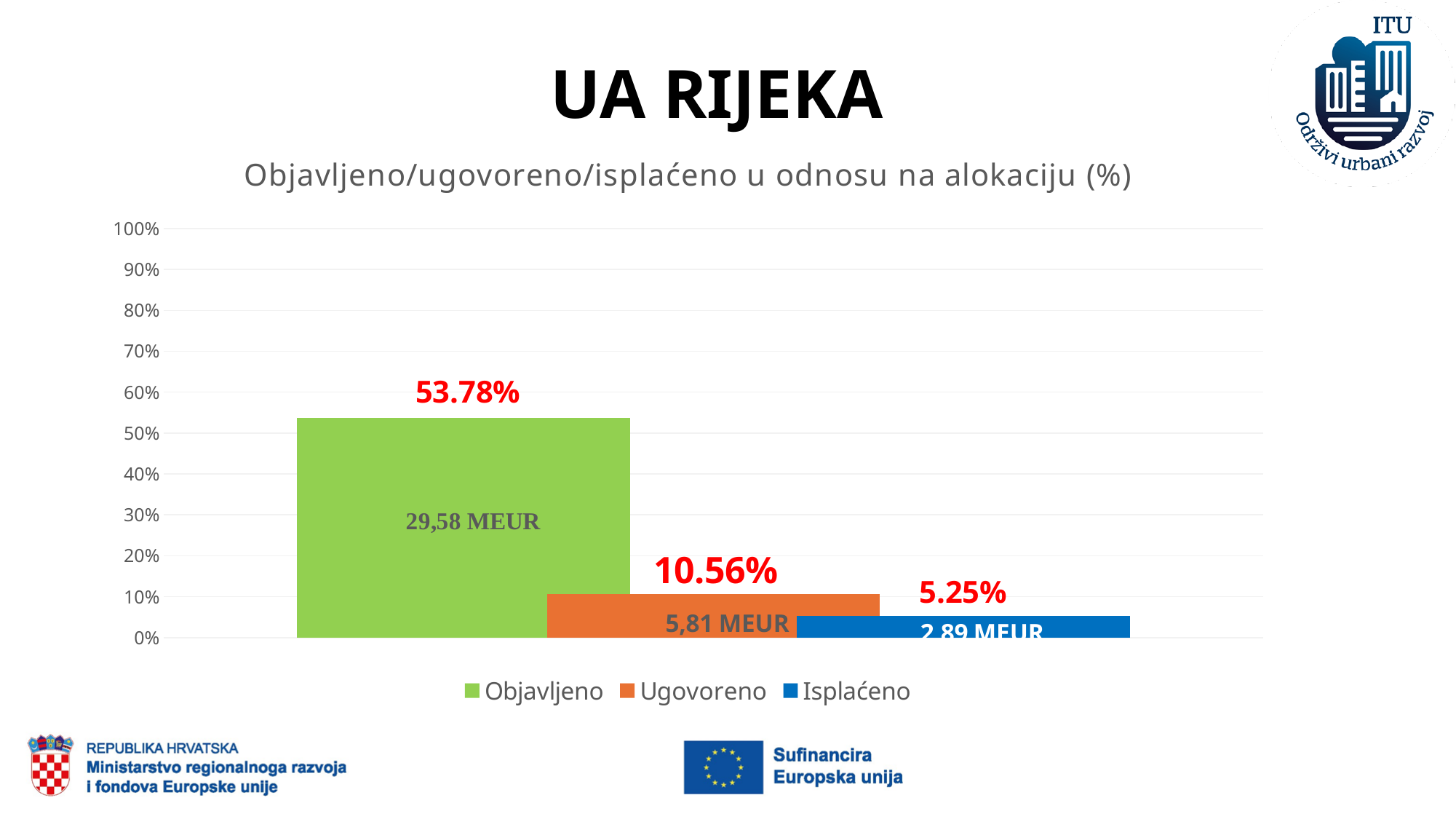
What amount in MEUR is labelled on the Ugovoreno bar? 5,81 MEUR How many series does the legend list? 3 Which series has the lowest percentage value? Isplaćeno What percentage value is shown for Isplaćeno? 5.25% Which is larger, the percentage for Ugovoreno or for Isplaćeno? Ugovoreno Which series has the highest percentage value? Objavljeno What amount in MEUR is labelled on the Objavljeno bar? 29,58 MEUR What percentage value is shown for Ugovoreno? 10.56% What kind of chart is shown on the slide? Bar chart What is the title of the chart? Objavljeno/ugovoreno/isplaćeno u odnosu na alokaciju (%) What percentage value is shown for Objavljeno? 53.78% What is the difference in percentage points between Objavljeno and Ugovoreno? 43.22%